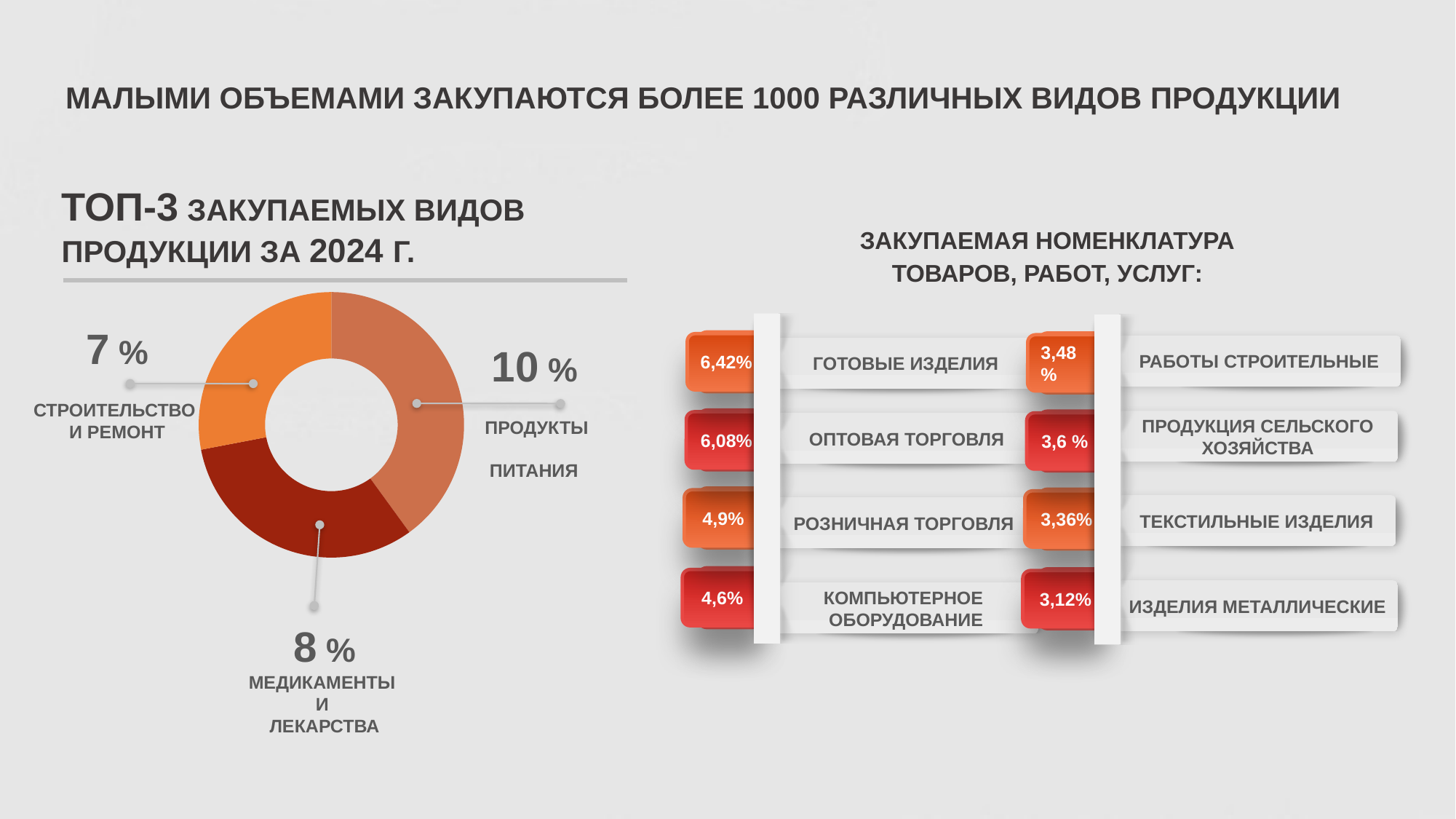
In the donut chart, what is the value for ПРОДУКТЫ ПИТАНИЯ? 10 % What kind of chart is shown on the left of the slide? Donut (pie) chart Which year does the donut chart's title refer to? 2024 How many categories are shown in the donut chart? 3 In the donut chart, what is the difference between the values for ПРОДУКТЫ ПИТАНИЯ and СТРОИТЕЛЬСТВО И РЕМОНТ? 3 % Which category in the donut chart has the highest value? ПРОДУКТЫ ПИТАНИЯ What is the title of the donut chart? ТОП-3 ЗАКУПАЕМЫХ ВИДОВ ПРОДУКЦИИ ЗА 2024 Г. In the donut chart, what is the value for СТРОИТЕЛЬСТВО И РЕМОНТ? 7 % In the donut chart, what is the difference between the values for МЕДИКАМЕНТЫ И ЛЕКАРСТВА and СТРОИТЕЛЬСТВО И РЕМОНТ? 1 % In the donut chart, which is larger: the value for ПРОДУКТЫ ПИТАНИЯ or the value for МЕДИКАМЕНТЫ И ЛЕКАРСТВА? ПРОДУКТЫ ПИТАНИЯ In the donut chart, what is the value for МЕДИКАМЕНТЫ И ЛЕКАРСТВА? 8 % Which category in the donut chart has the lowest value? СТРОИТЕЛЬСТВО И РЕМОНТ